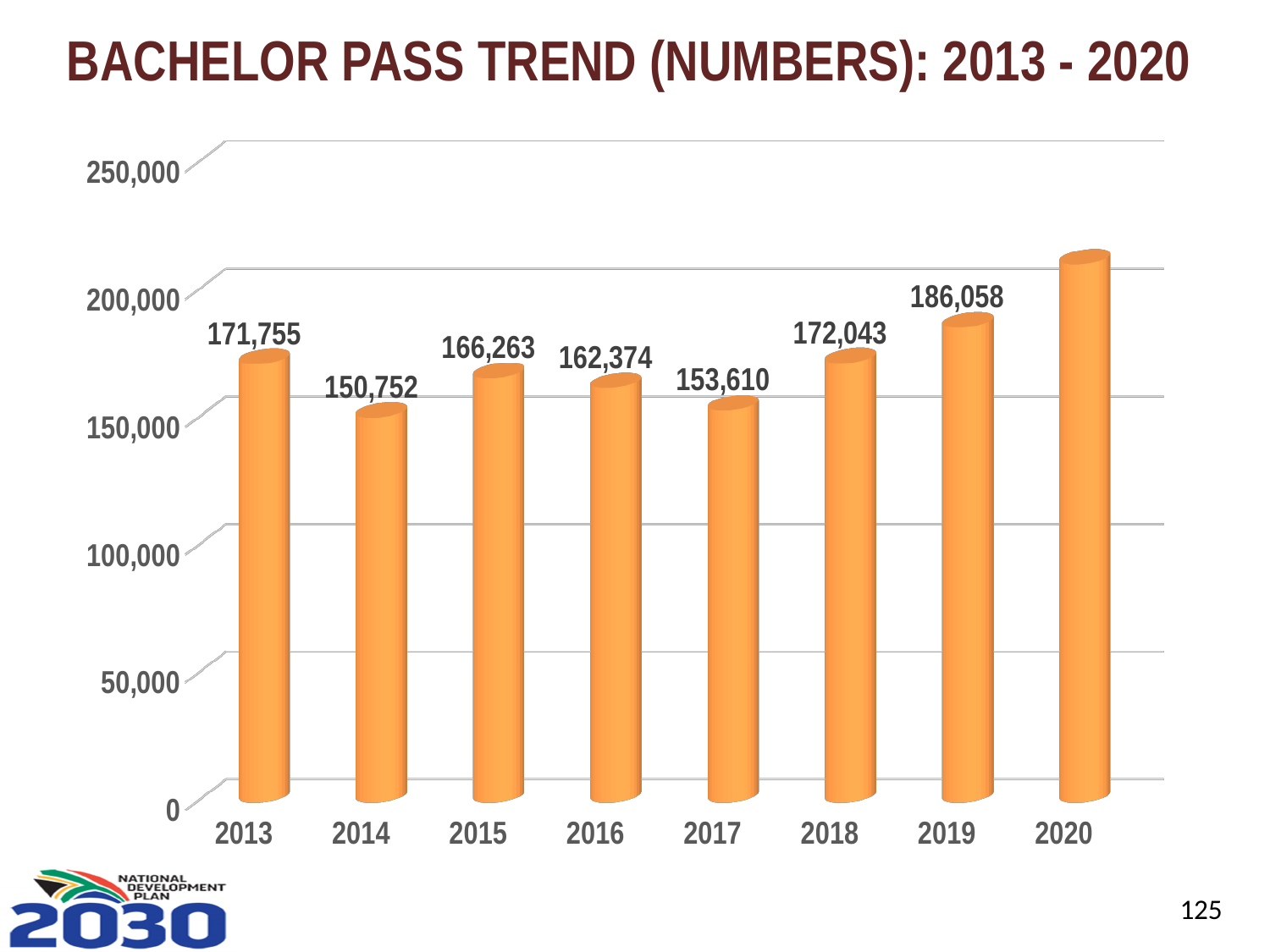
Which year has the highest number of bachelor passes? 2020 Is the value for 2020 greater or less than 200,000? greater What is the number of bachelor passes in 2013? 171,755 What kind of chart is shown on the slide? Bar chart Did the number of bachelor passes rise or fall from 2017 to 2020? Rise Which year had more bachelor passes, 2015 or 2016? 2015 What is the number of bachelor passes in 2017? 153,610 Which year has the lowest number of bachelor passes? 2014 What is the difference between the number of bachelor passes in 2013 and in 2014? 21,003 What is the number of bachelor passes in 2019? 186,058 How many years are shown on the x axis of the chart? 8 What is the difference between the number of bachelor passes in 2019 and in 2018? 14,015